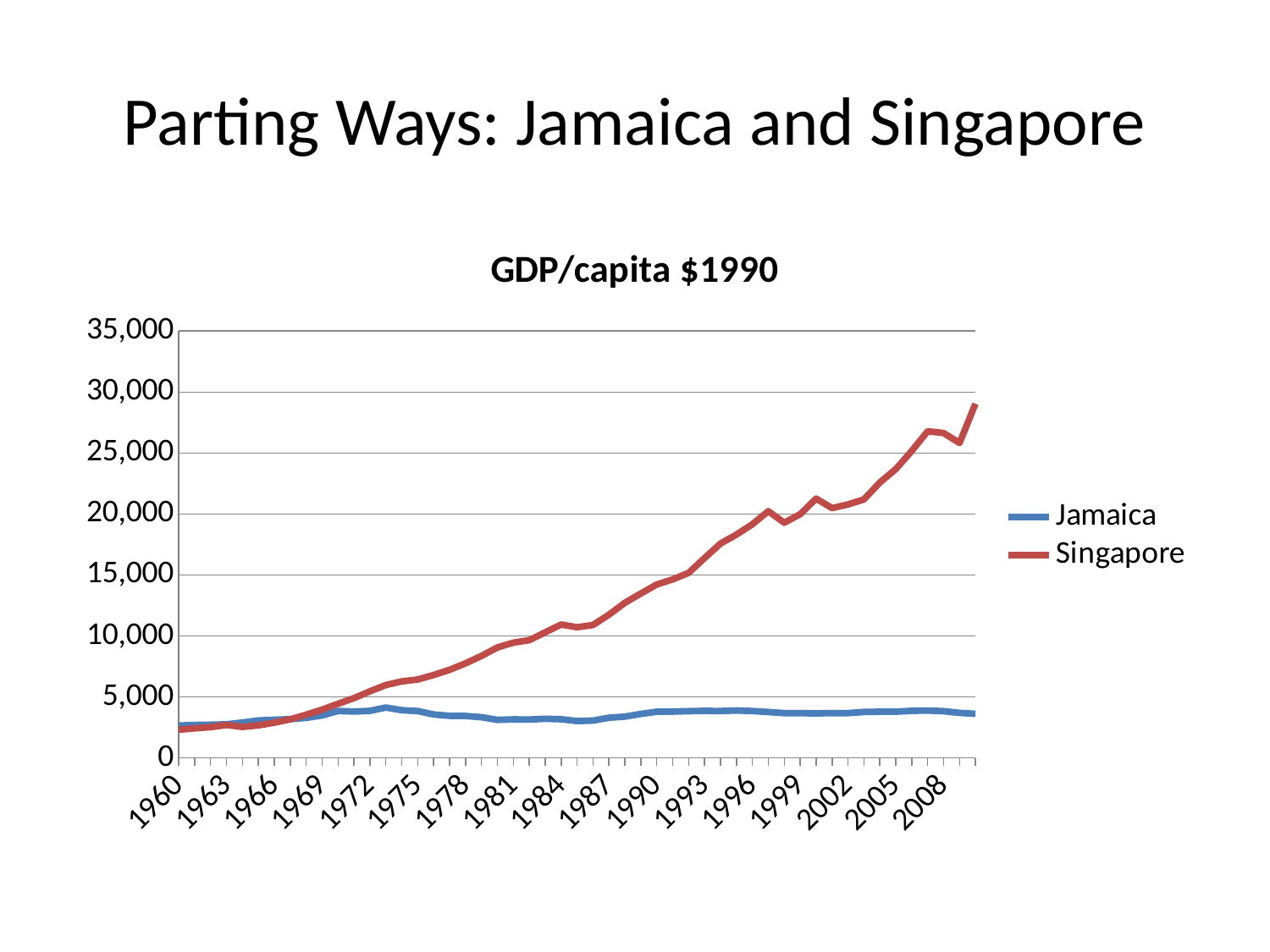
Is the value for Singapore in 1978 greater or less than 5,000? greater Is the value for Jamaica in 2008 greater or less than 5,000? less What is the title of the chart? GDP/capita $1990 Which series has the higher value in 2008, Jamaica or Singapore? Singapore What kind of chart is shown on the slide? line chart Does the Singapore line generally rise or fall from 1960 to the end of the series? rise How many series does the legend list? 2 Which colour is used for the Singapore line? red Is the value for Singapore in 2008 greater or less than 25,000? greater Which series reaches the highest value on the chart? Singapore